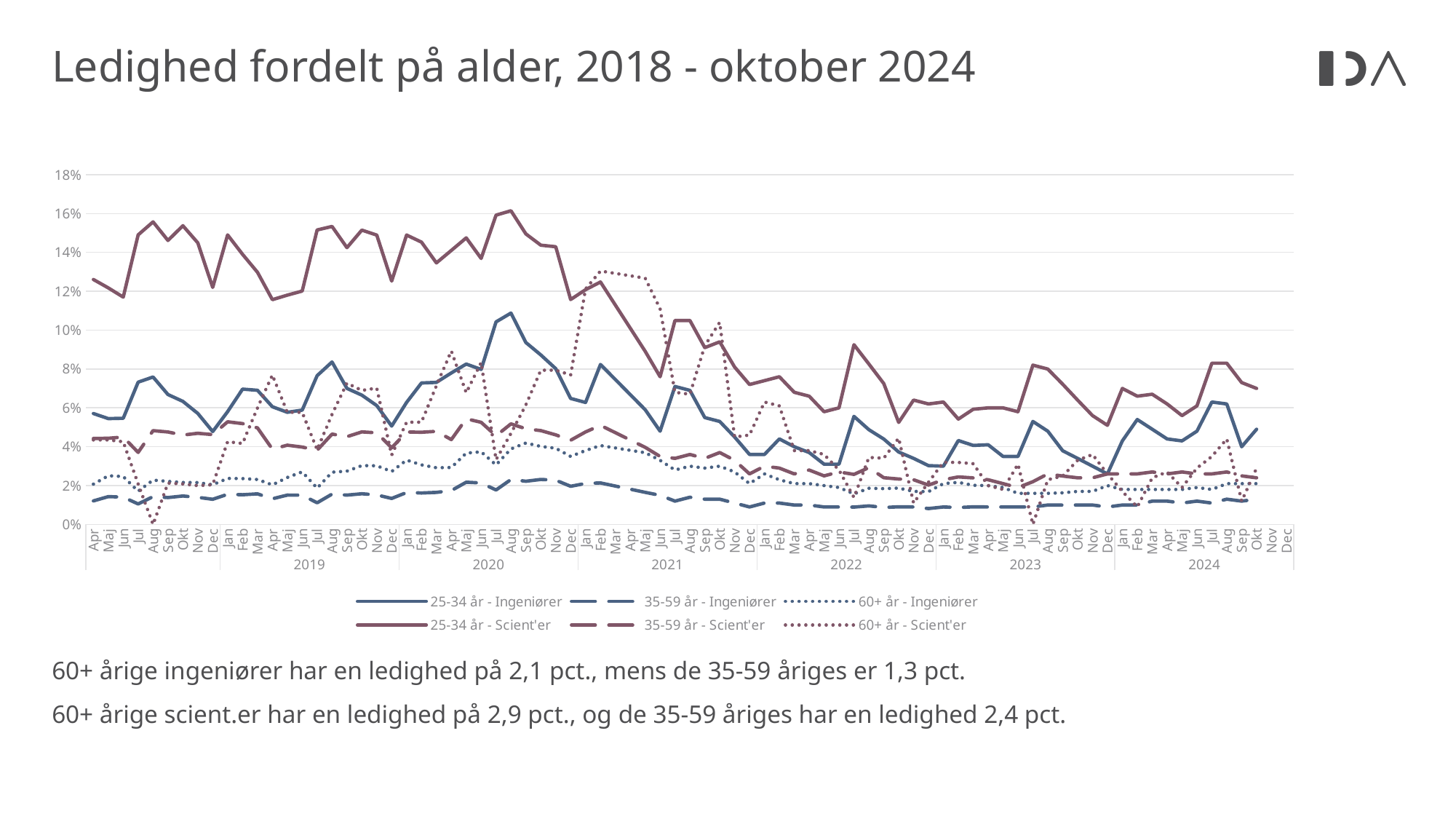
According to the text on the slide, what is the unemployment rate for 60+ årige ingeniører? 2,1 pct. Is the value for 25-34 år - Scient'er in Aug 2020 greater or less than 14%? greater Does the 25-34 år - Scient'er series rise or fall from early 2020 to the end of 2022? fall Is the value for 25-34 år - Ingeniører in Aug 2020 greater or less than 10%? greater Is the value for 35-59 år - Ingeniører in Okt 2024 greater or less than 2%? less What kind of chart is shown on the slide? line chart What is the highest value shown on the y axis? 18% Which series has the highest values across the chart? 25-34 år - Scient'er Which series has the lowest values across the chart? 35-59 år - Ingeniører What is the title of the chart? Ledighed fordelt på alder, 2018 - oktober 2024 How many series does the legend list? 6 According to the text on the slide, what is the unemployment rate for 35-59 årige scient.er? 2,4 pct.